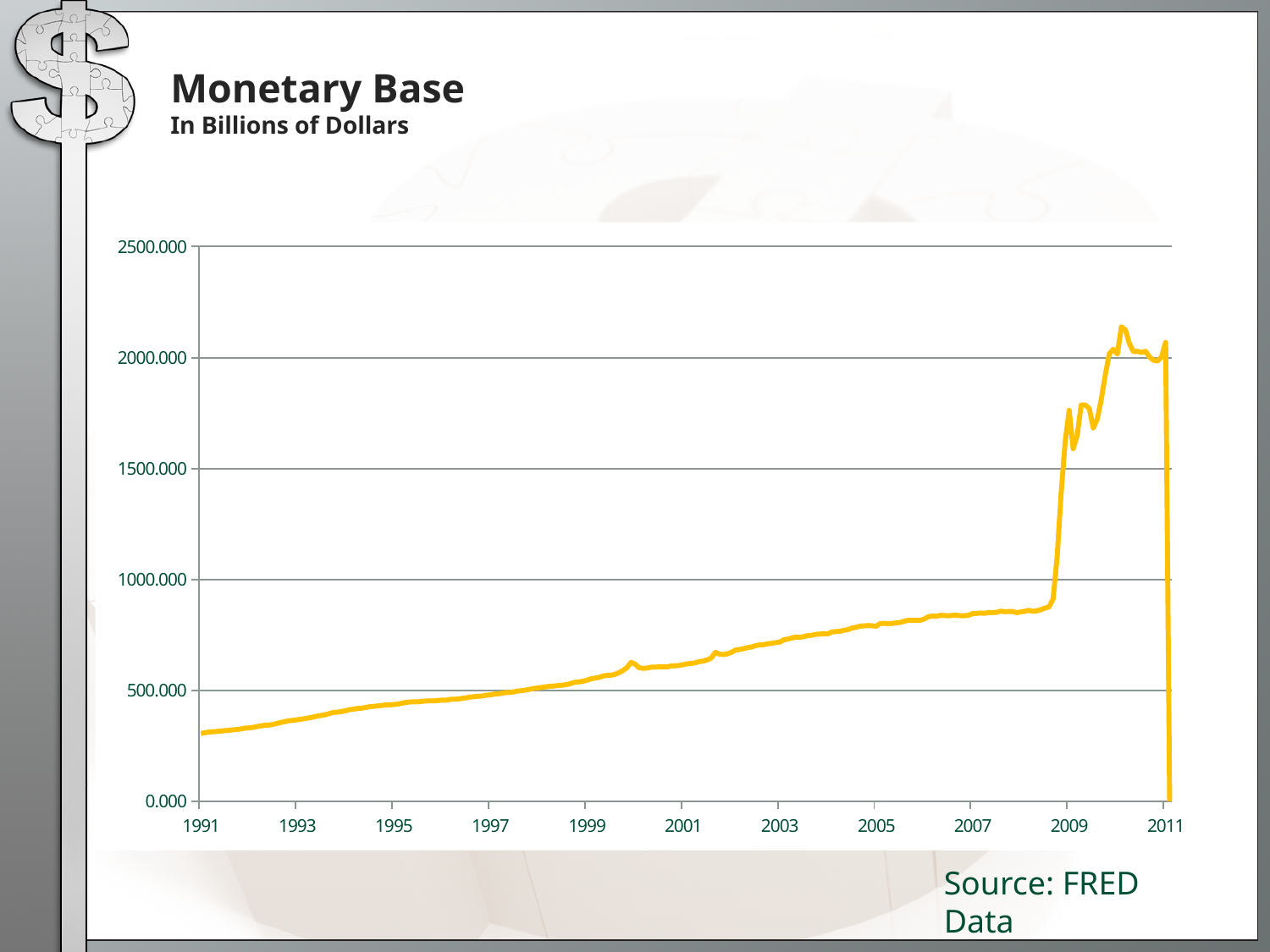
Which year has the larger monetary base, 1995 or 2005? 2005 What is the highest value shown on the y axis? 2500.000 Is the value for 2005 greater or less than 500? greater Is the value for 1991 greater or less than 500? less Is the value for 2009 greater or less than 1500? greater Does the monetary base generally rise or fall from 1991 to 2010? rise What kind of chart is shown on the slide? line chart What is the title of the chart? Monetary Base In what units are the values on the chart expressed, according to the subtitle? Billions of Dollars How many year labels are shown on the x axis? 11